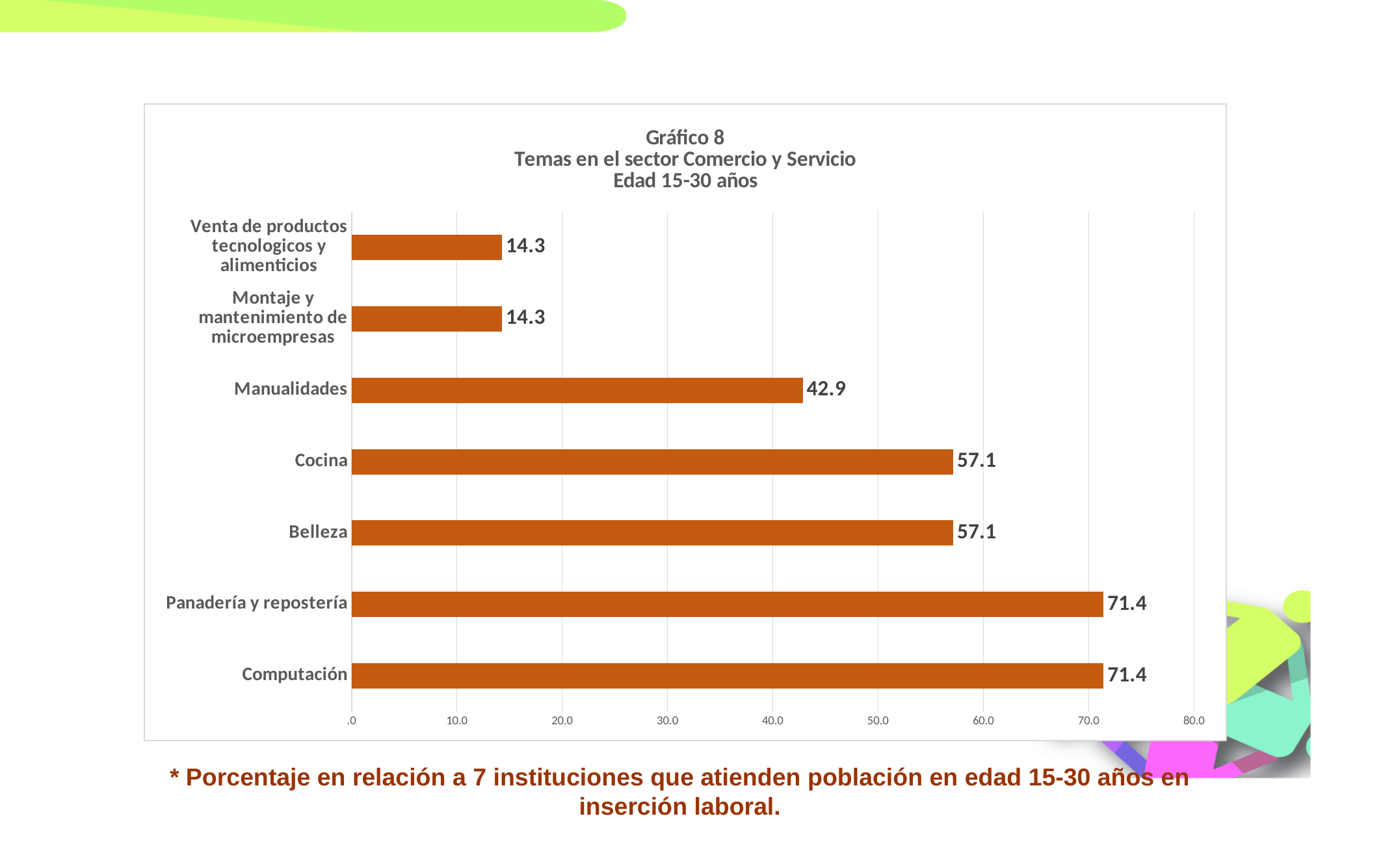
How many categories are shown in the chart? 7 What is the title of the chart? Gráfico 8 Temas en el sector Comercio y Servicio Edad 15-30 años What is the value for Cocina? 57.1 Is the value for Cocina greater or less than 50.0? greater Which categories have the highest value? Computación and Panadería y repostería What is the value for Montaje y mantenimiento de microempresas? 14.3 What is the value for Manualidades? 42.9 Which is larger, the value for Belleza or the value for Manualidades? Belleza Which categories have the lowest value? Venta de productos tecnologicos y alimenticios and Montaje y mantenimiento de microempresas What is the value for Computación? 71.4 What kind of chart is shown on the slide? Bar chart What is the difference between the values for Panadería y repostería and Manualidades? 28.5